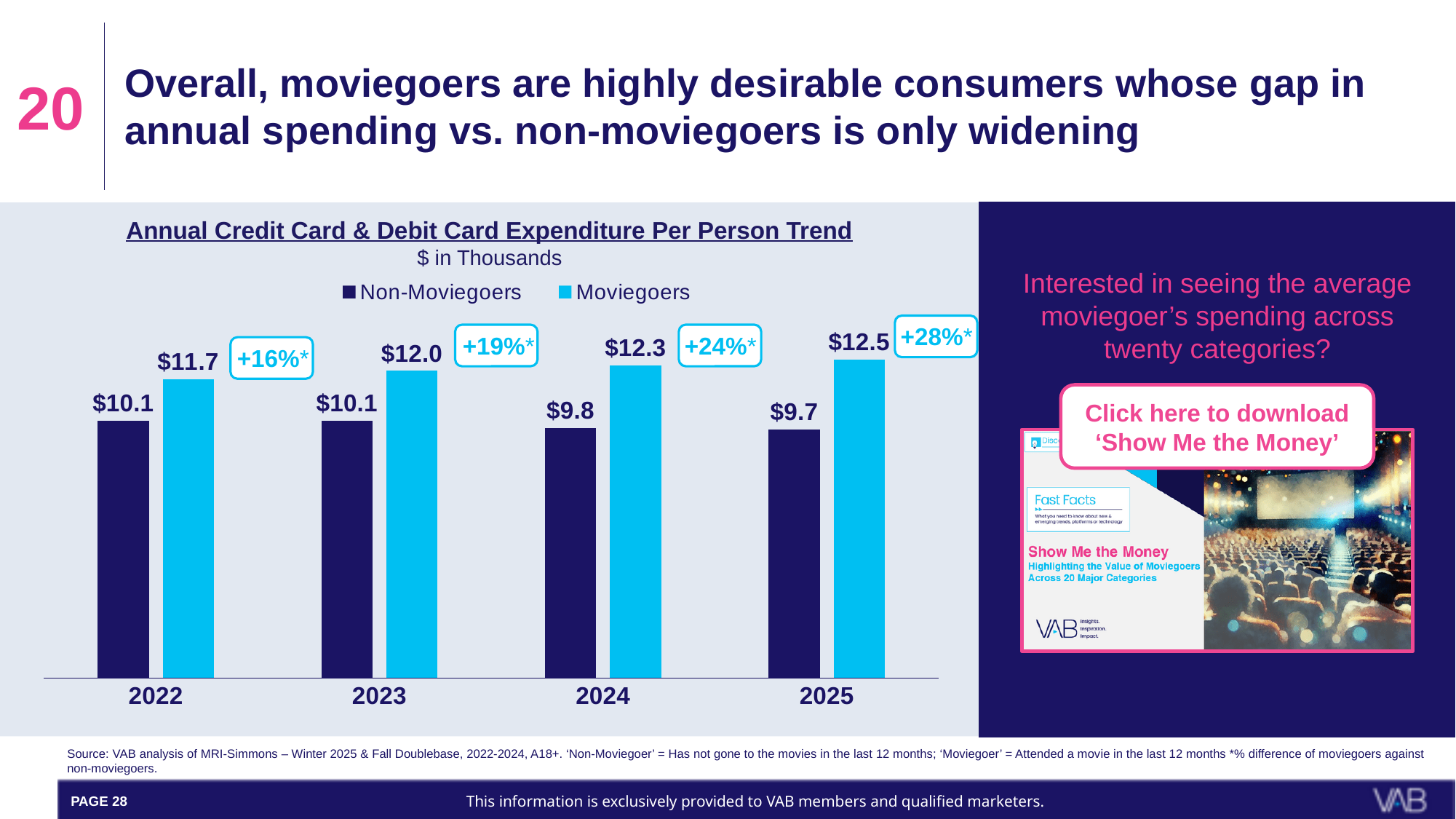
How many series does the legend list? 2 In which year is the Moviegoers value highest? 2025 What kind of chart is shown on the slide? Bar chart What is the value for Non-Moviegoers in 2025? $9.7 What is the difference between the Moviegoers values in 2022 and 2025? $0.8 What is the difference between the Moviegoers and Non-Moviegoers values in 2025? $2.8 In which year is the Non-Moviegoers value lowest? 2025 Which is larger in 2023, the Moviegoers value or the Non-Moviegoers value? Moviegoers Do the Non-Moviegoers values rise or fall from 2023 to 2025? Fall How many years are shown on the x axis? 4 What is the value for Non-Moviegoers in 2022? $10.1 What is the value for Moviegoers in 2024? $12.3